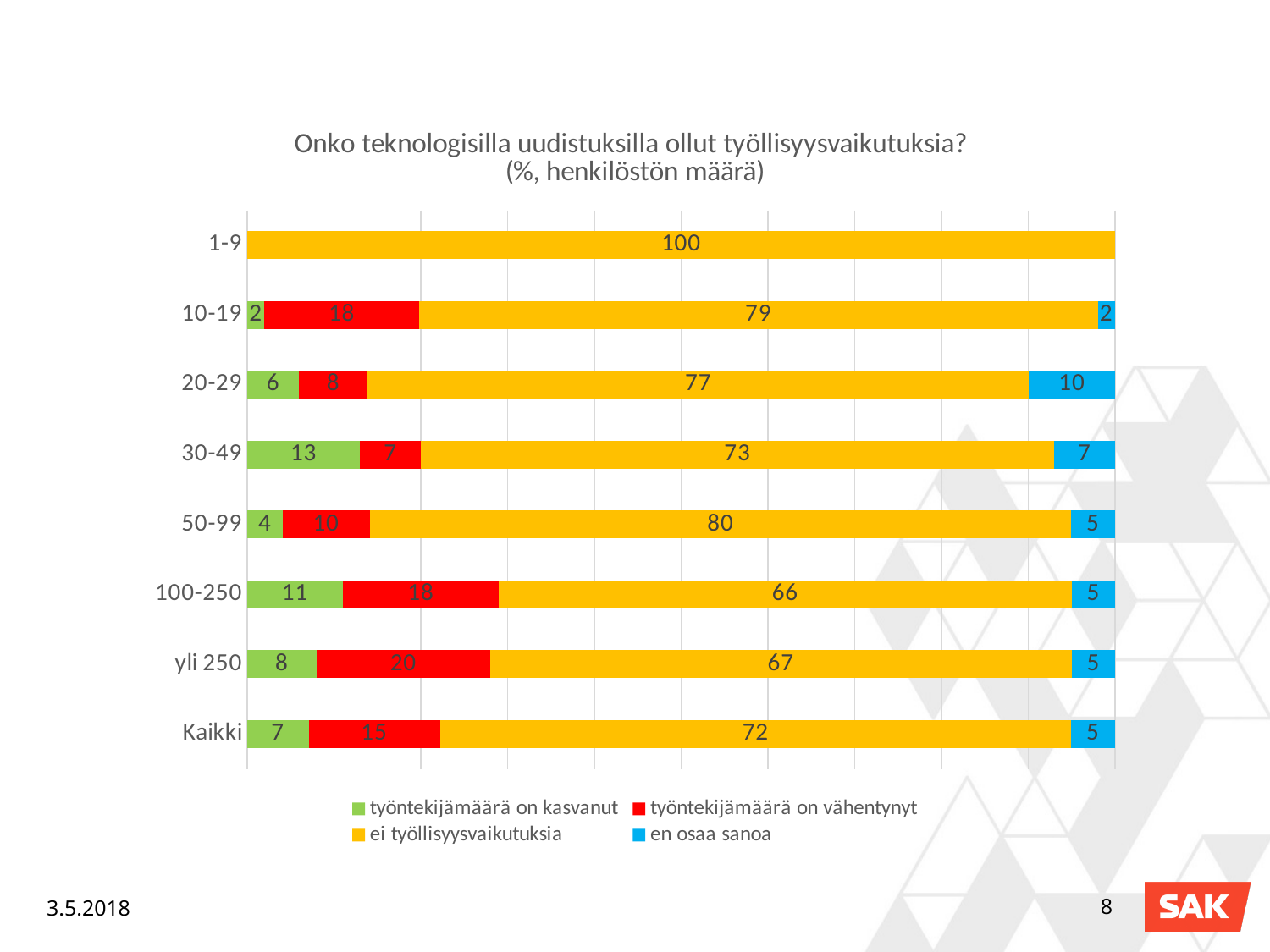
Which group has the lowest value for 'ei työllisyysvaikutuksia'? 100-250 Which is larger: 'työntekijämäärä on vähentynyt' for 10-19 or for 20-29? 10-19 What is the total of the stacked bar for the Kaikki group? 99 Which colour represents 'en osaa sanoa' in the chart? blue How many categories (company size groups) are shown on the chart? 8 What kind of chart is shown on the slide? stacked bar chart How many series does the legend list? 4 What is the value of 'työntekijämäärä on vähentynyt' for the yli 250 group? 20 Which group has the highest value for 'työntekijämäärä on kasvanut'? 30-49 What is the value of 'ei työllisyysvaikutuksia' for the 30-49 group? 73 What is the difference between the 'ei työllisyysvaikutuksia' values for the 1-9 group and the Kaikki group? 28 What is the value of 'en osaa sanoa' for the 20-29 group? 10